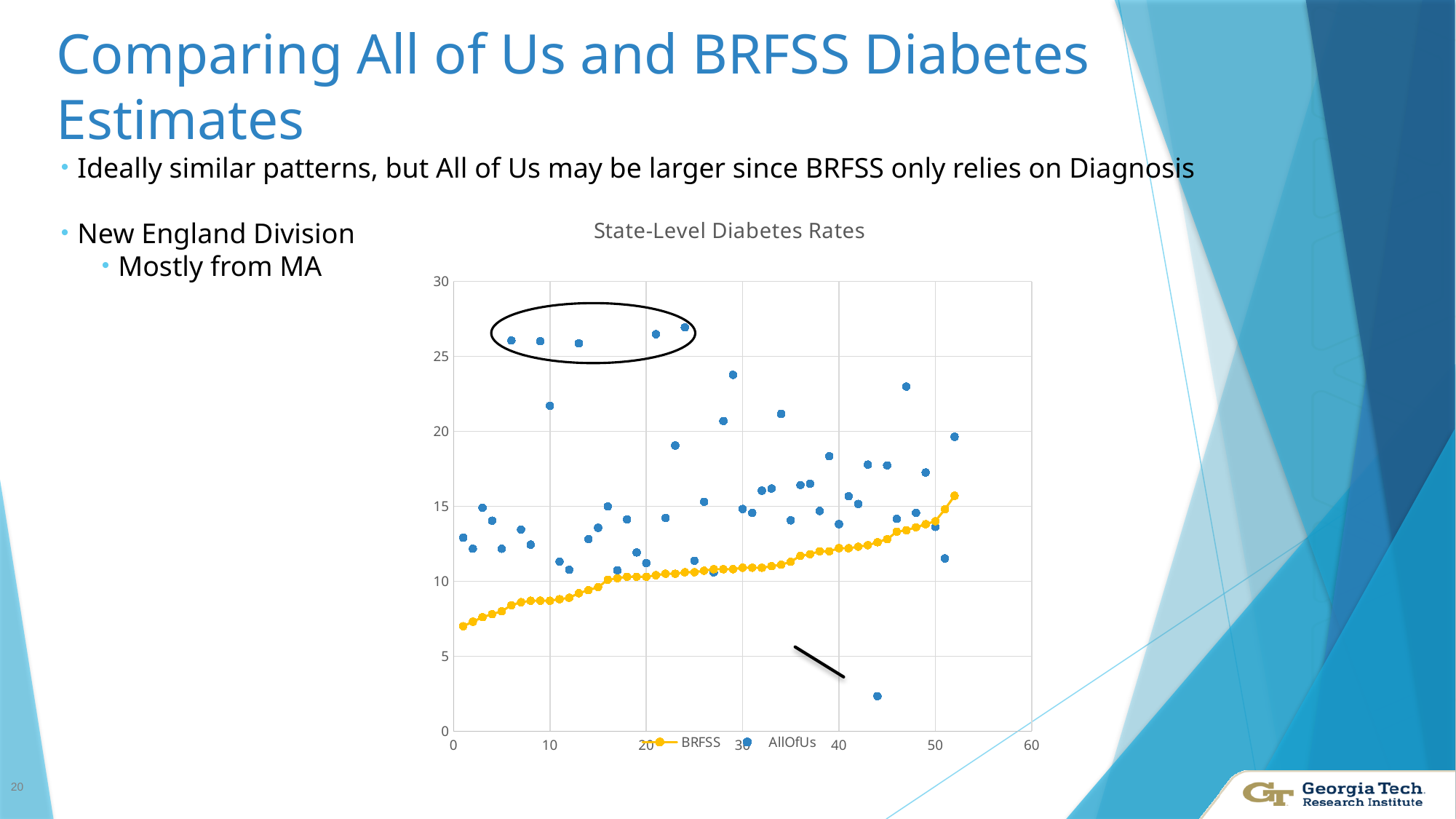
Which series reaches the highest value on the chart, BRFSS or AllOfUs? AllOfUs What kind of chart is shown on the slide? Scatter chart Are the circled AllOfUs values greater or less than 25? greater Is the first BRFSS value (at x = 1) greater or less than 10? less Is the highest BRFSS value greater or less than 20? less Which two series are listed in the chart legend? BRFSS and AllOfUs Do the BRFSS values rise or fall as the x axis increases? Rise Which series contains the lowest value on the chart, BRFSS or AllOfUs? AllOfUs How many series does the chart legend list? 2 What is the title of the chart? State-Level Diabetes Rates